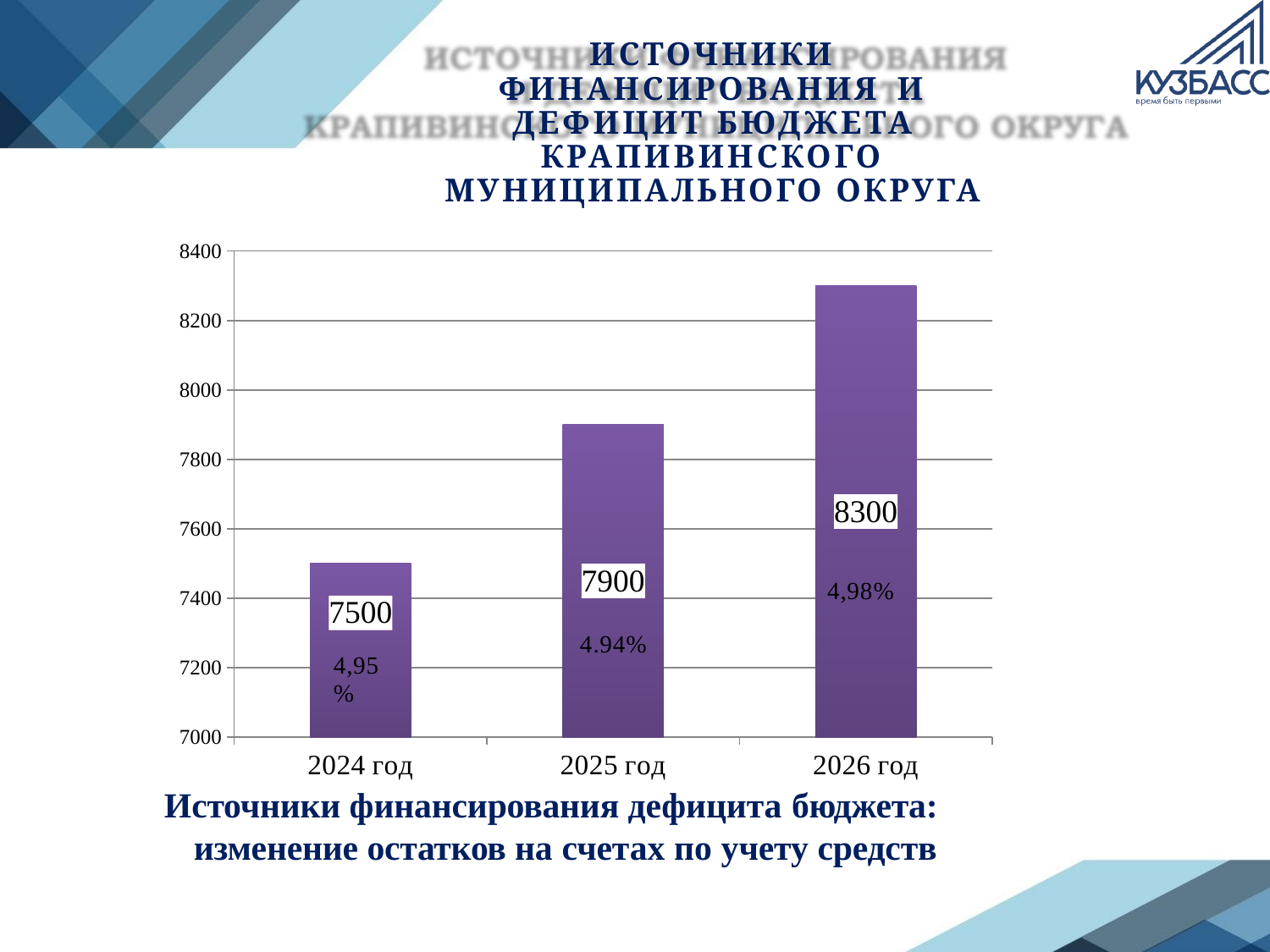
How many bars are shown in the chart? 3 What is the value for 2025 год? 7900 What kind of chart is shown on the slide? bar chart Do the values rise or fall from 2024 год to 2026 год? rise Which year has the highest value? 2026 год What is the difference between the values for 2026 год and 2024 год? 800 What is the value for 2026 год? 8300 What is the value for 2024 год? 7500 Which is larger, the value for 2025 год or the value for 2026 год? 2026 год Is the value for 2025 год greater or less than 8000? less Which year has the lowest value? 2024 год What is the difference between the values for 2025 год and 2024 год? 400